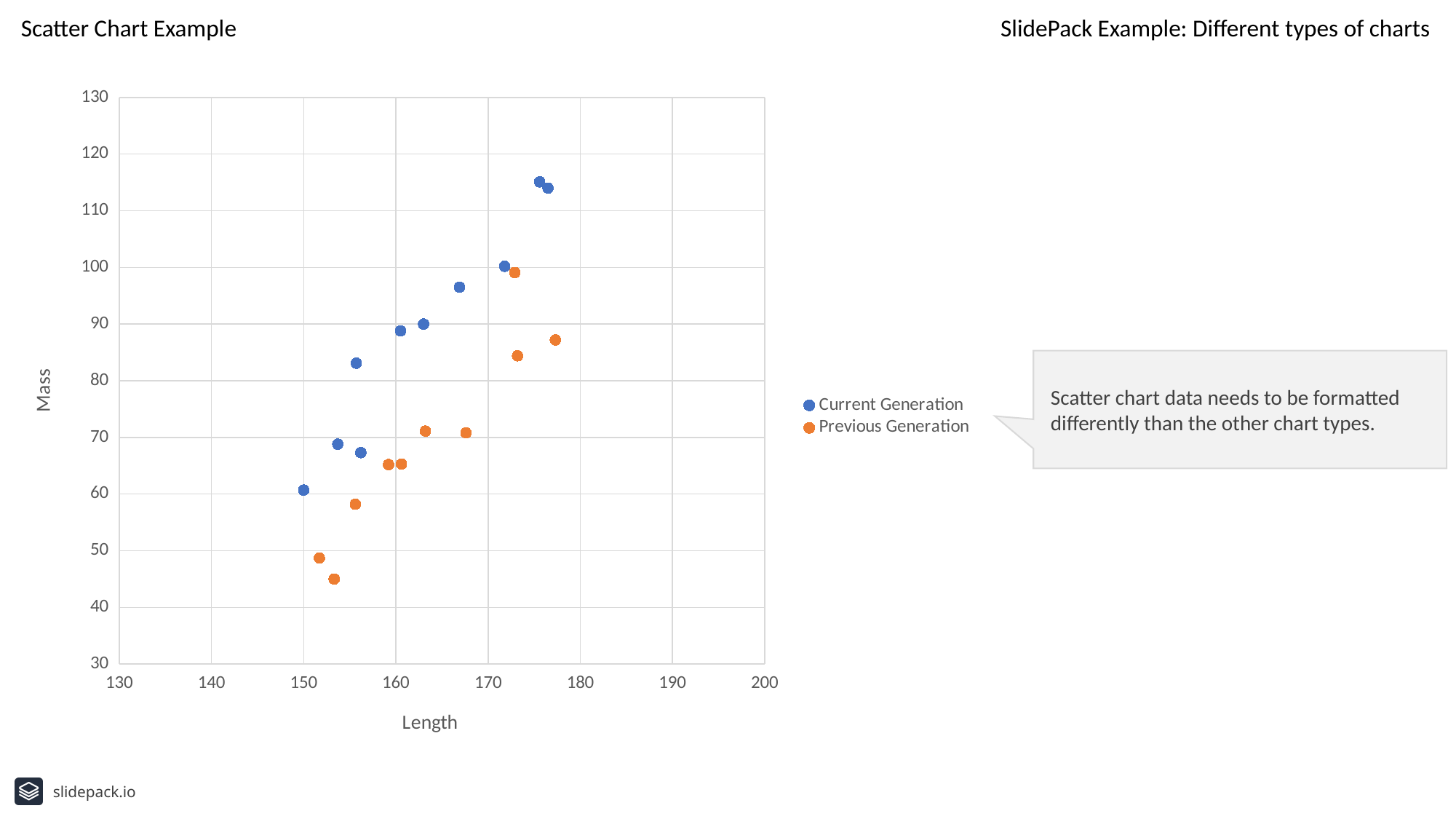
Is the lowest Mass value for Previous Generation greater or less than 50? less How many points are plotted for the Current Generation series? 10 What is the title of the chart? Scatter Chart Example What kind of chart is shown on the slide? Scatter chart How many series does the legend list? 2 Does Mass generally rise or fall as Length increases for the Current Generation series? rise What are the labels of the x axis and the y axis? Length (x axis) and Mass (y axis) Is the lowest Mass value for Current Generation greater or less than 70? less Which series contains the point with the lowest Mass value? Previous Generation Is the highest Mass value for Current Generation greater or less than 110? greater Which series contains the point with the highest Mass value? Current Generation